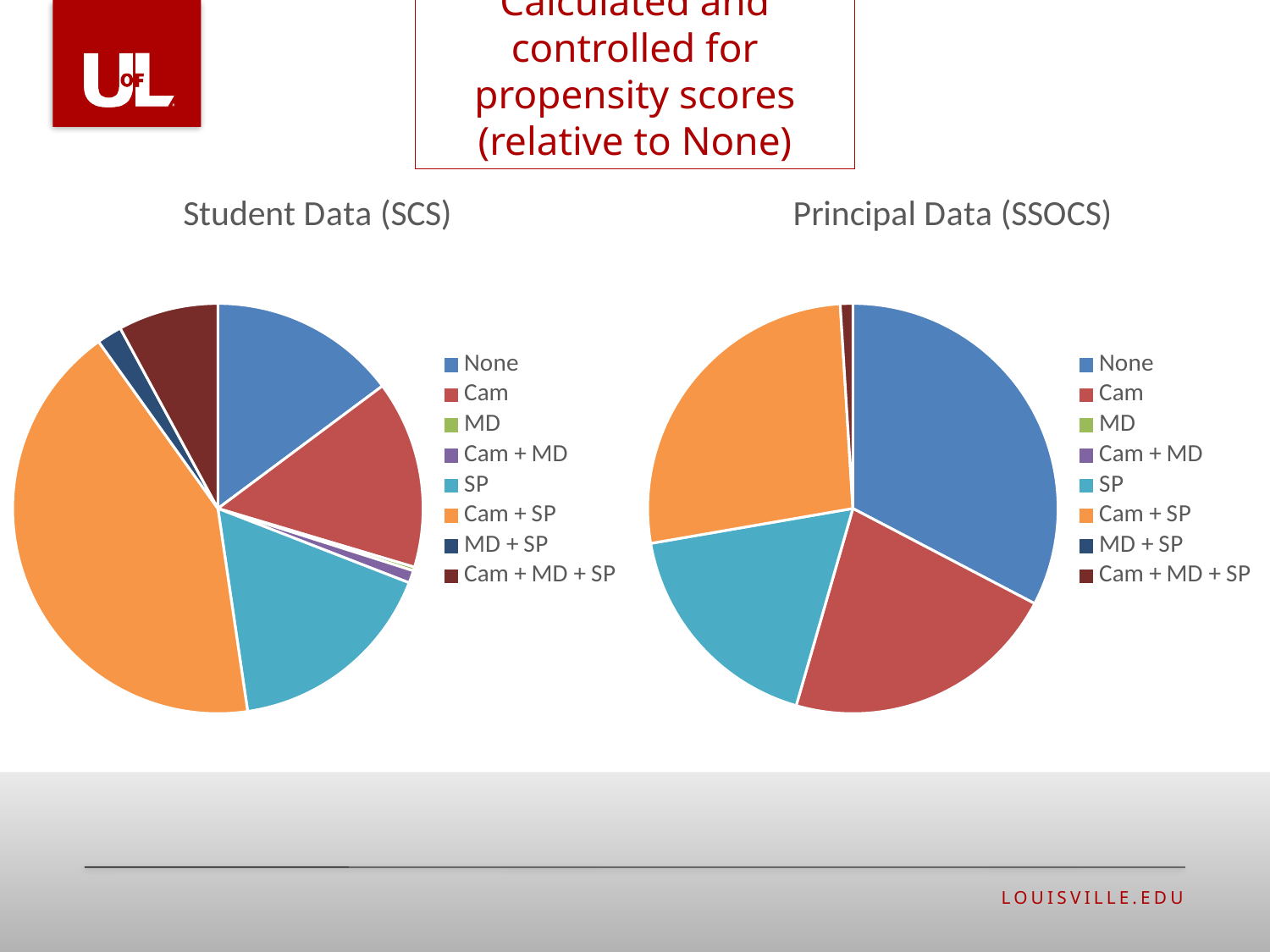
In the Student Data (SCS) chart, which slice is larger, None or Cam + SP? Cam + SP In the Student Data (SCS) chart, which category has the largest slice? Cam + SP How many categories does the legend of the Principal Data (SSOCS) chart list? 8 What is the title of the pie chart on the left of the slide? Student Data (SCS) In the Principal Data (SSOCS) chart, which slice is larger, Cam + SP or Cam + MD + SP? Cam + SP In the Principal Data (SSOCS) chart, what colour is the Cam + SP slice? orange In the Student Data (SCS) chart, which slice is larger, SP or Cam + MD + SP? SP What kind of chart is the Student Data (SCS) chart? pie chart What kind of chart is the Principal Data (SSOCS) chart? pie chart How many categories does the legend of the Student Data (SCS) chart list? 8 In the Principal Data (SSOCS) chart, which category has the largest slice? None